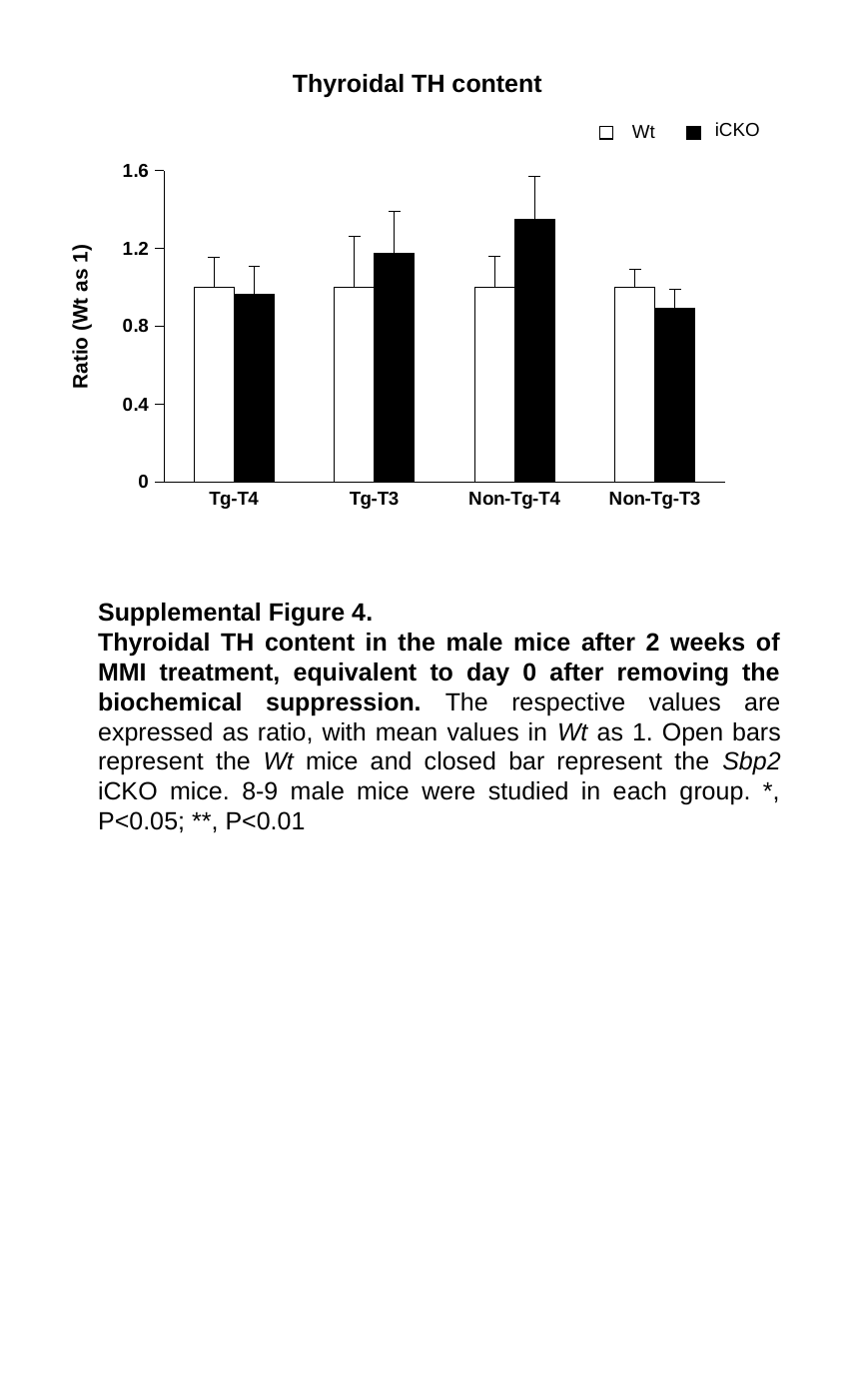
For Non-Tg-T3, which series has the larger value, Wt or iCKO? Wt Is the iCKO value for Tg-T4 greater or less than 1.2? less Which series is represented by the black (closed) bars? iCKO What kind of chart is shown on the slide? bar chart How many series does the legend list? 2 How many categories are shown on the x axis? 4 Is the iCKO value for Non-Tg-T3 greater or less than 1.2? less For Non-Tg-T4, which series has the larger value, Wt or iCKO? iCKO Is the iCKO value for Non-Tg-T4 greater or less than 1.2? greater For which category is the iCKO bar the highest? Non-Tg-T4 What is the title of the chart? Thyroidal TH content